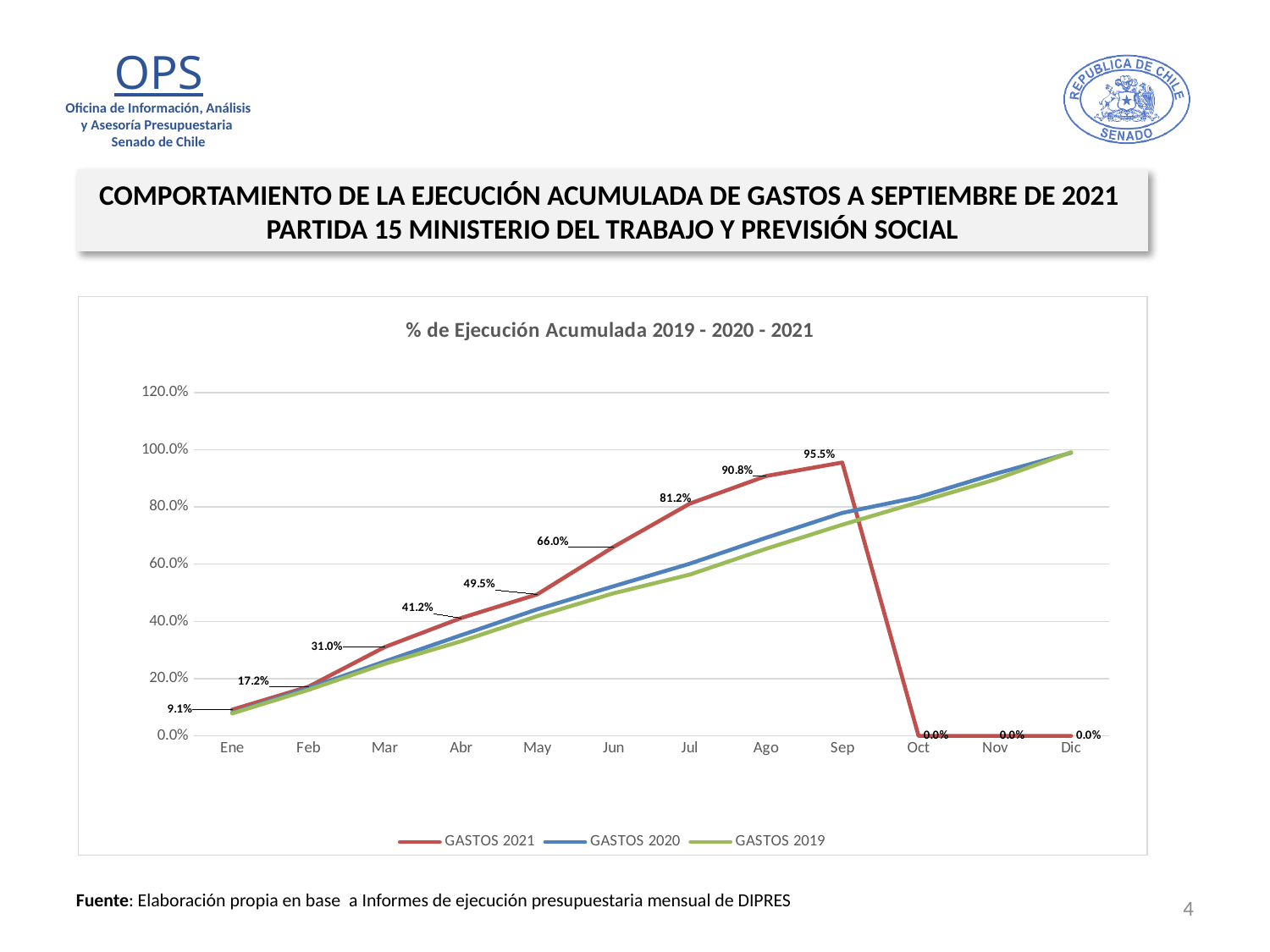
How many months are shown on the x axis? 12 Is the value for GASTOS 2020 in Sep greater or less than 60.0%? greater What is the value for GASTOS 2021 in Sep? 95.5% Is the value for GASTOS 2019 in Jul greater or less than 60.0%? less What is the title of the chart? % de Ejecución Acumulada 2019 - 2020 - 2021 What is the difference between the GASTOS 2021 values for Ago and Jul? 9.6% What is the value for GASTOS 2021 in Jun? 66.0% Does the GASTOS 2021 line rise or fall from Ene to Sep? rise What is the value for GASTOS 2021 in Mar? 31.0% In which month does GASTOS 2021 reach its highest value? Sep What type of chart is shown on the slide? line chart How many series does the legend list? 3